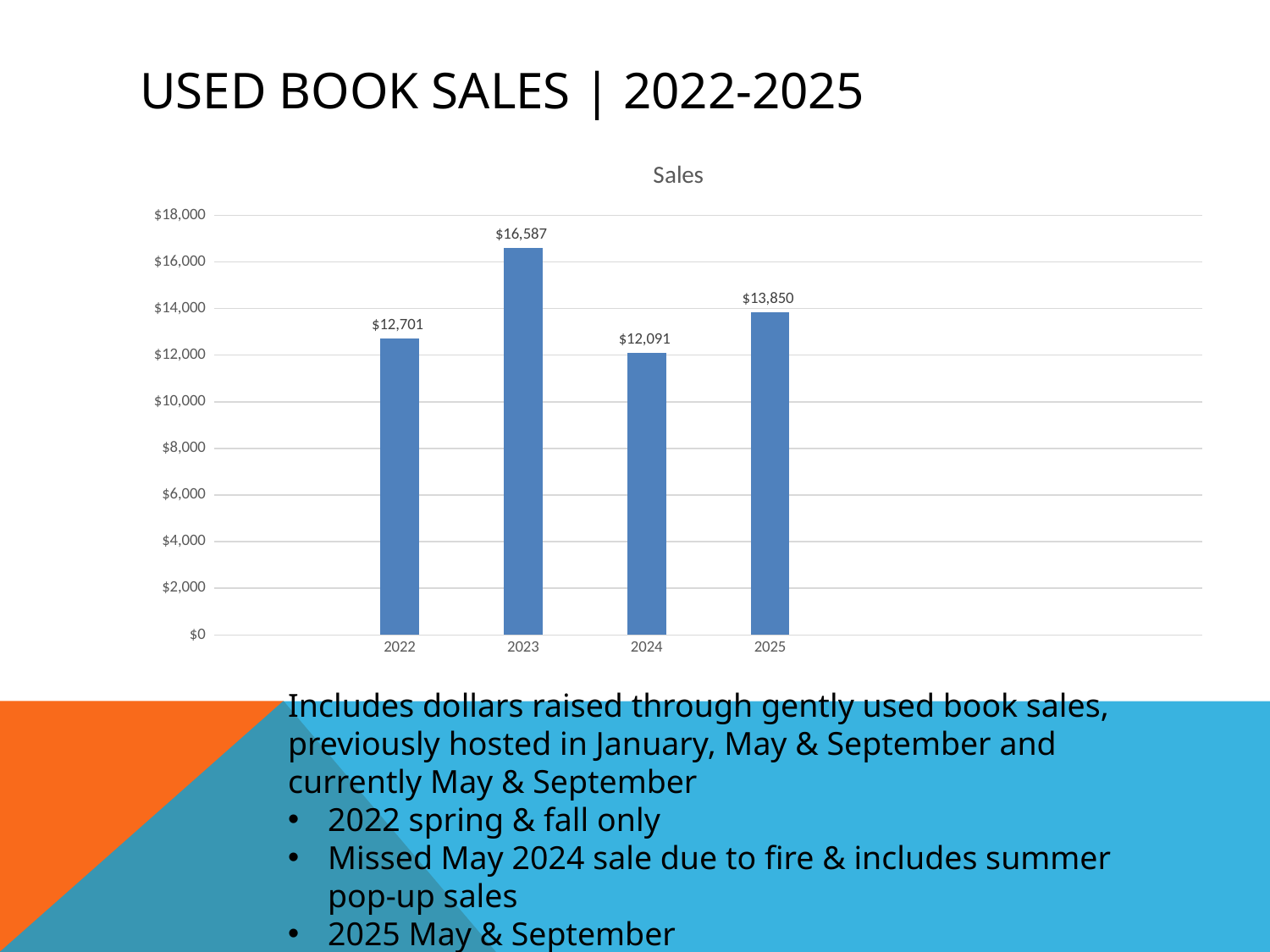
What is the difference in sales between 2023 and 2022? $3,886 What is the title of the chart? Sales What were the sales in 2025? $13,850 What kind of chart is shown on the slide? Bar chart What is the difference in sales between 2025 and 2024? $1,759 How many years are shown on the chart? 4 What were the sales in 2023? $16,587 Which year had higher sales, 2022 or 2025? 2025 What were the sales in 2024? $12,091 Which year had the lowest sales? 2024 Is the value for 2023 greater or less than $16,000? greater Which year had the highest sales? 2023